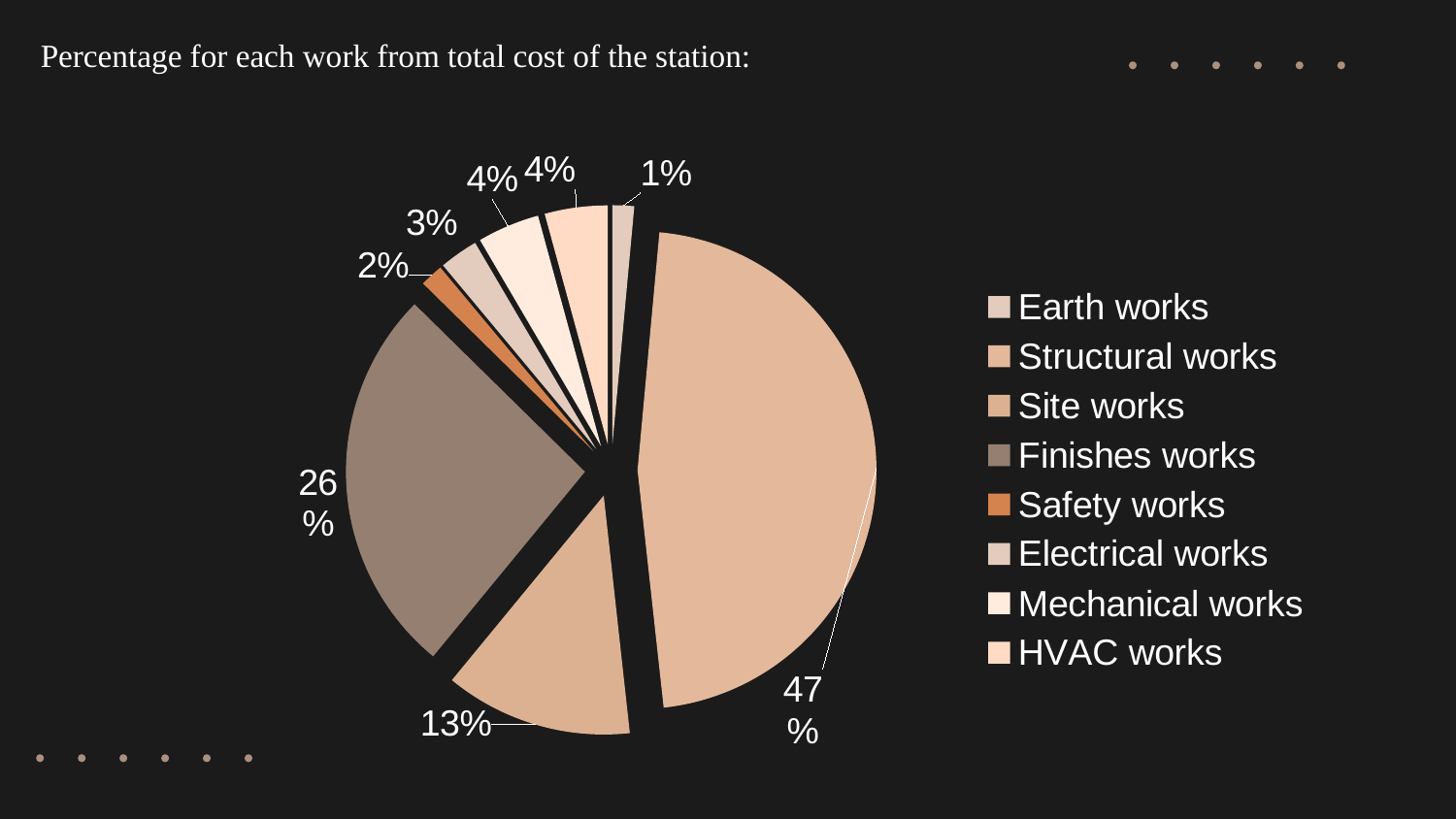
What percentage of the total cost is Structural works? 47% How many categories does the legend list? 8 Which category has the largest share of the total cost? Structural works What percentage of the total cost is Earth works? 1% Which category has the smallest share of the total cost? Earth works What percentage of the total cost is Safety works? 2% What percentage of the total cost is Site works? 13% What percentage of the total cost is Finishes works? 26% What is the difference in percentage points between Structural works and Finishes works? 21 What is the title of the chart? Percentage for each work from total cost of the station: Which has a larger share, Site works or Finishes works? Finishes works What kind of chart is shown on the slide? pie chart